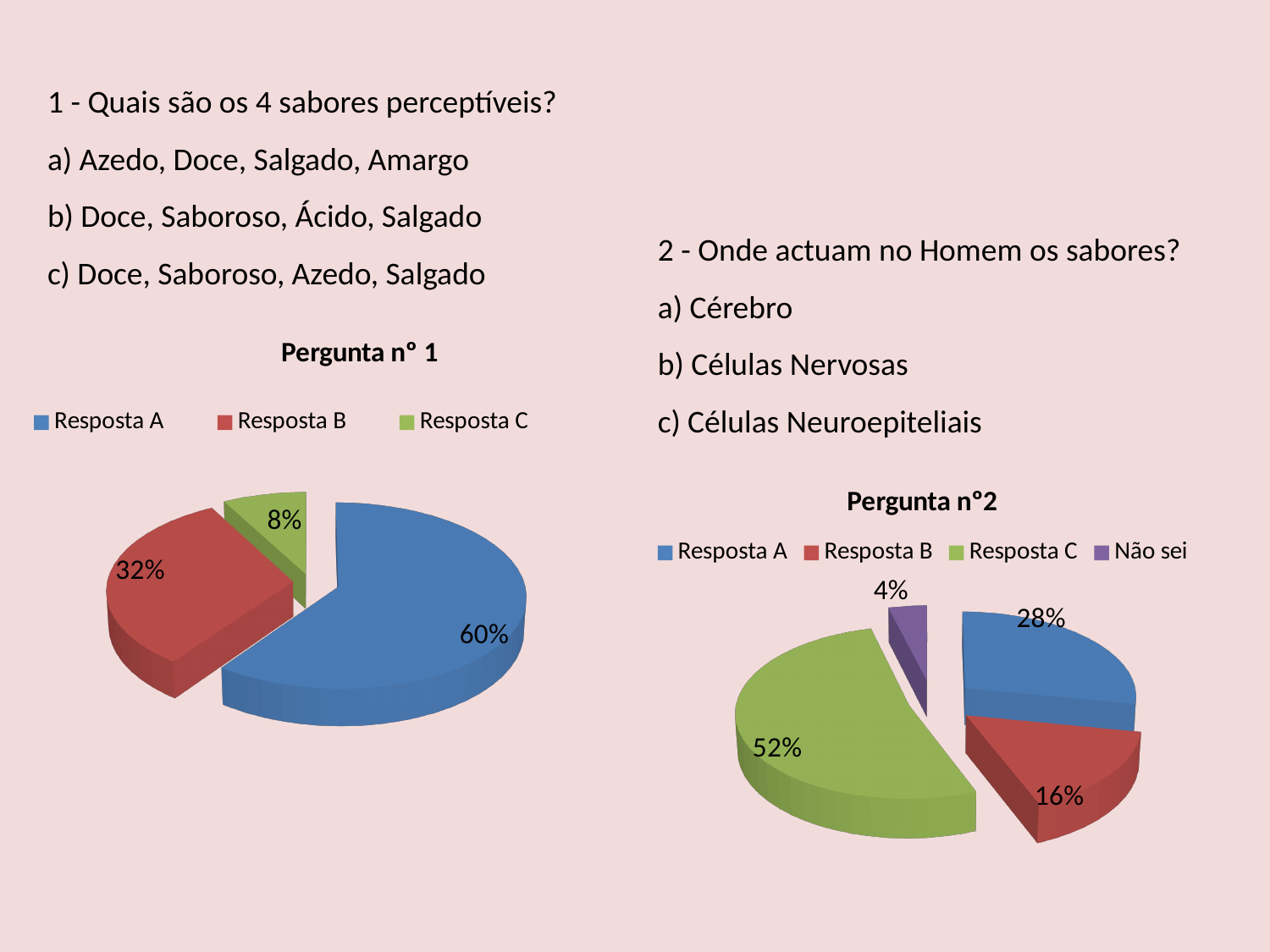
In the 'Pergunta nº 1' chart, what is the difference between the shares of Resposta A and Resposta B? 28% In the 'Pergunta nº2' chart, what share does Resposta C have? 52% In the 'Pergunta nº 1' chart, what share does Resposta A have? 60% In the 'Pergunta nº2' chart, which is larger, Resposta A or Resposta B? Resposta A In the 'Pergunta nº2' chart, how many series does the legend list? 4 In the 'Pergunta nº2' chart, what share does 'Não sei' have? 4% What kind of chart is 'Pergunta nº 1'? Pie chart In the 'Pergunta nº 1' chart, which response has the largest share? Resposta A In the 'Pergunta nº 1' chart, how many series does the legend list? 3 In the 'Pergunta nº2' chart, which response has the smallest share? Não sei In the 'Pergunta nº2' chart, what is the difference between the shares of Resposta C and Resposta A? 24% In the 'Pergunta nº 1' chart, what share does Resposta C have? 8%